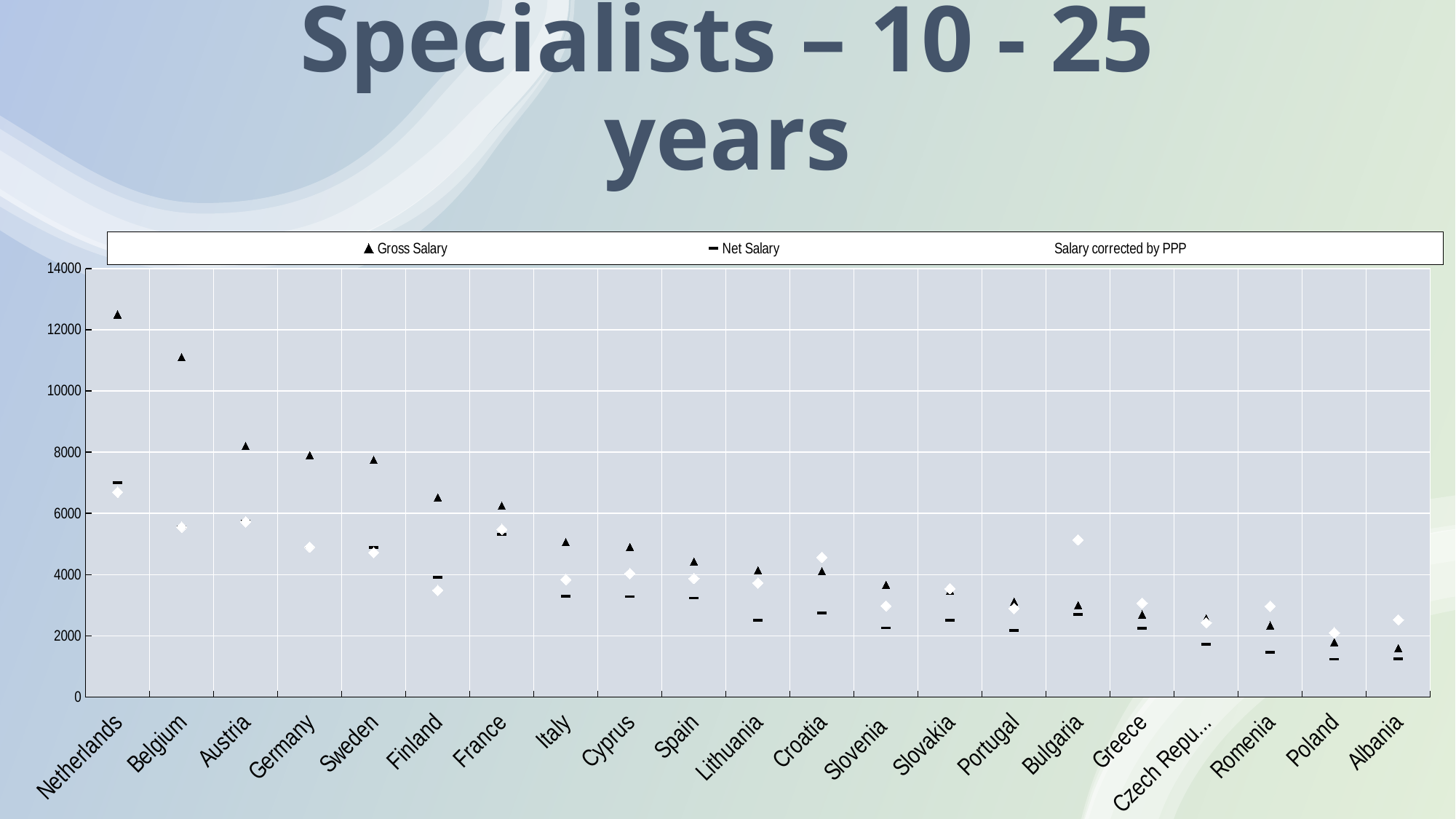
Is the Salary corrected by PPP for Bulgaria greater or less than 4000? greater What marker shape does the legend use for Gross Salary? triangle How many countries are shown on the x axis? 21 Do the Gross Salary values generally rise or fall from left to right along the x axis? fall Is the Gross Salary for Netherlands greater or less than 12000? greater How many series does the legend list? 3 Which country has the highest Salary corrected by PPP? Netherlands Is the Gross Salary for Finland greater or less than 6000? greater Which country has the highest Gross Salary? Netherlands Which is larger, the Salary corrected by PPP for Bulgaria or for Greece? Bulgaria